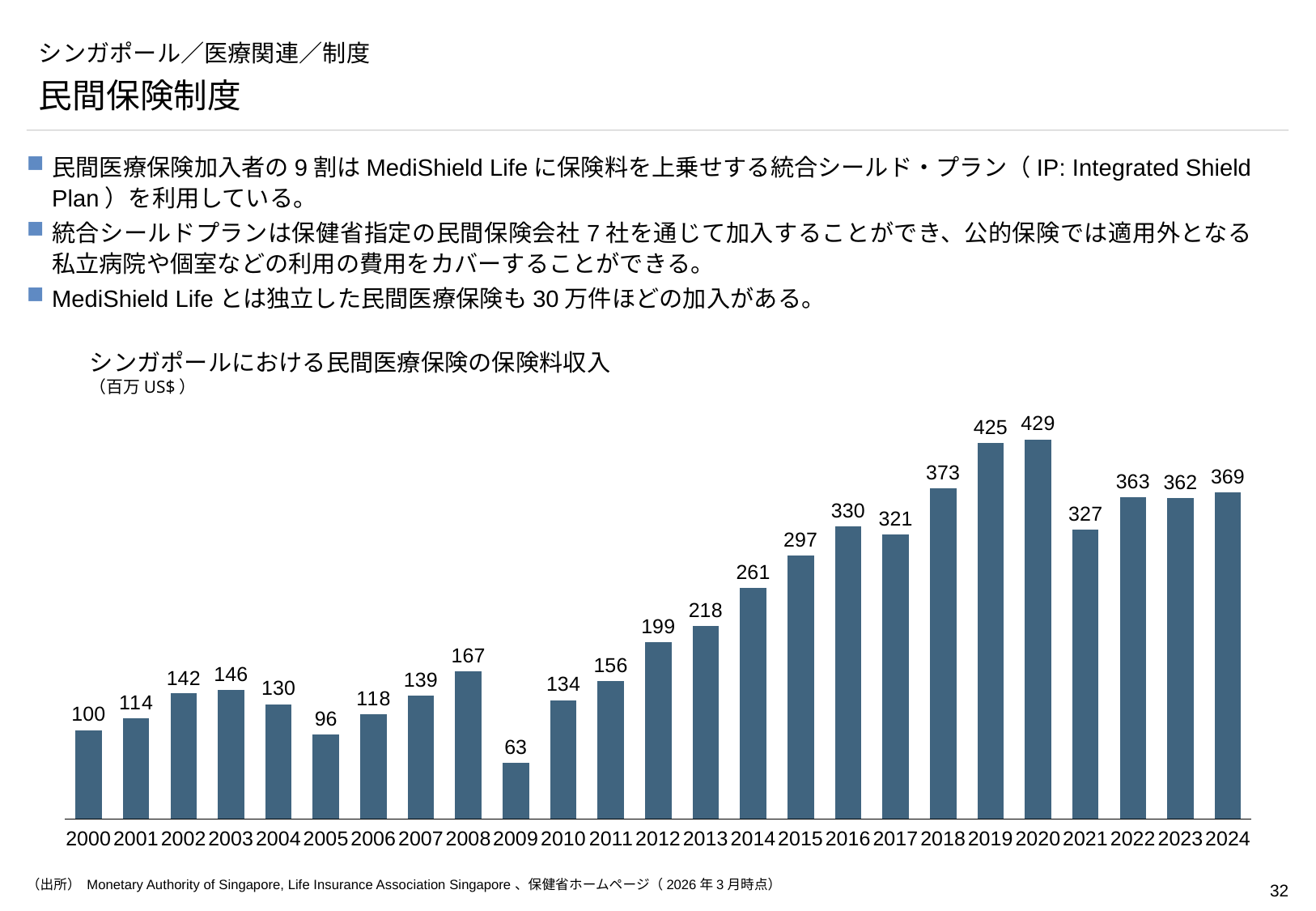
Which is larger, the value for 2008 or the value for 2010? 2008 Do the values rise or fall from 2010 to 2020? rise What is the difference between the values for 2020 and 2021? 102 What is the value for 2014? 261 What is the value for 2009? 63 How many years are shown on the x axis? 25 What is the title of the chart? シンガポールにおける民間医療保険の保険料収入 What is the value for 2020? 429 What kind of chart is this? bar chart What unit is shown under the chart title? 百万US$ Which year has the highest value? 2020 Which year has the lowest value? 2009